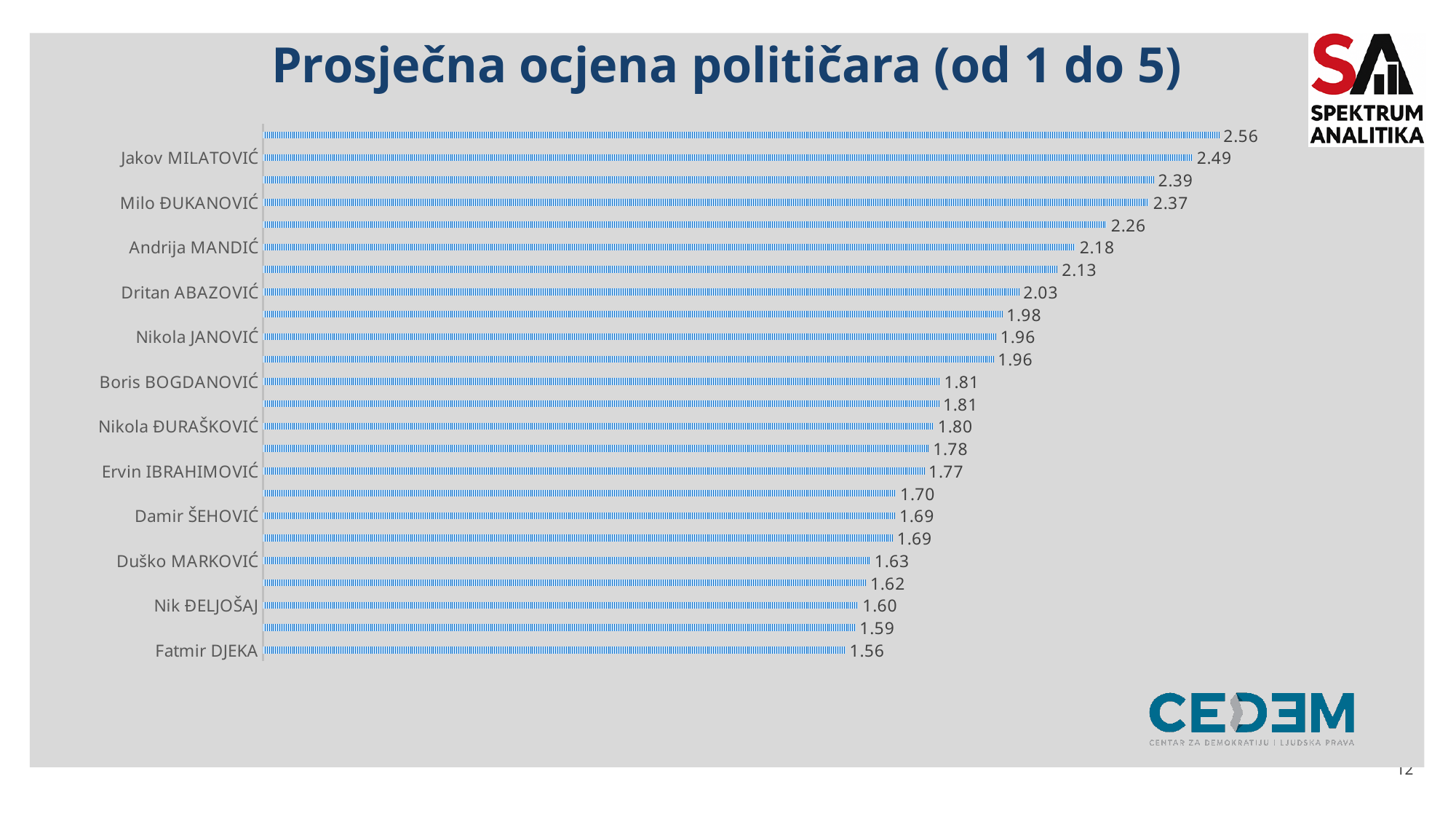
What is the title of the chart? Prosječna ocjena političara (od 1 do 5) How many bars are plotted on the chart? 24 What is the average rating shown for Fatmir DJEKA? 1.56 What is the average rating shown for Dritan ABAZOVIĆ? 2.03 What is the difference between the ratings of Jakov MILATOVIĆ and Milo ĐUKANOVIĆ? 0.12 What type of chart is shown on the slide? Bar chart What is the average rating shown for Duško MARKOVIĆ? 1.63 Who has the higher average rating, Andrija MANDIĆ or Nikola JANOVIĆ? Andrija MANDIĆ What is the average rating shown for Jakov MILATOVIĆ? 2.49 What is the average rating shown for Milo ĐUKANOVIĆ? 2.37 What is the highest value printed on the chart? 2.56 Which labelled politician has the lowest average rating on the chart? Fatmir DJEKA